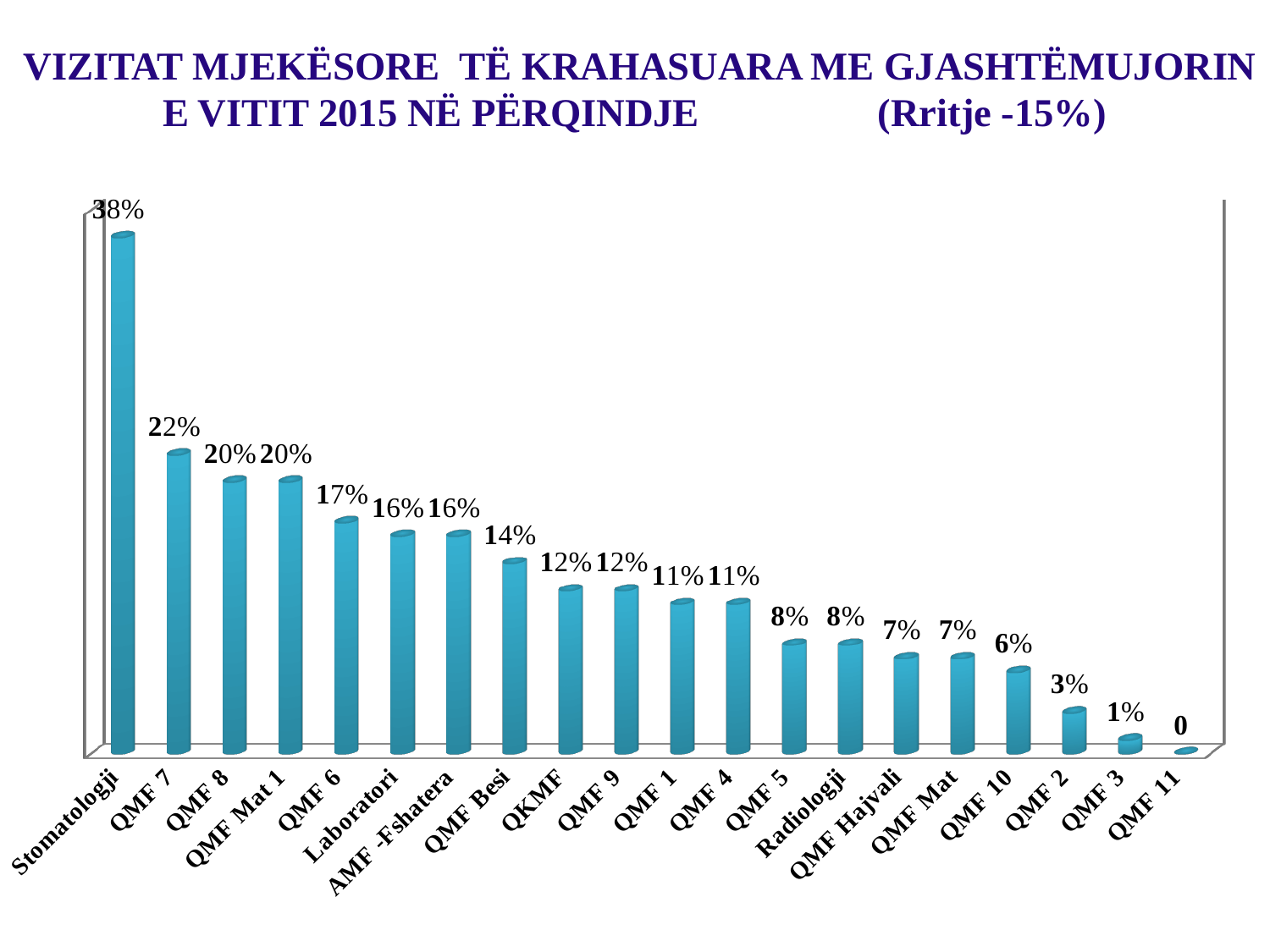
What is the difference between the values for Stomatologji and QMF 7? 16% What is the difference between the values for QMF 6 and QMF 10? 11% Which category has the highest value? Stomatologji Which is larger, the value for QMF 8 or the value for QMF 5? QMF 8 What is the value for QMF 11? 0 How many categories are shown on the chart? 20 Do the values rise or fall from left to right along the x axis? Fall What kind of chart is shown on the slide? Bar chart Which category has the lowest value? QMF 11 What is the value for Stomatologji? 38% What is the value for QMF Besi? 14% What is the value for QMF Hajvali? 7%